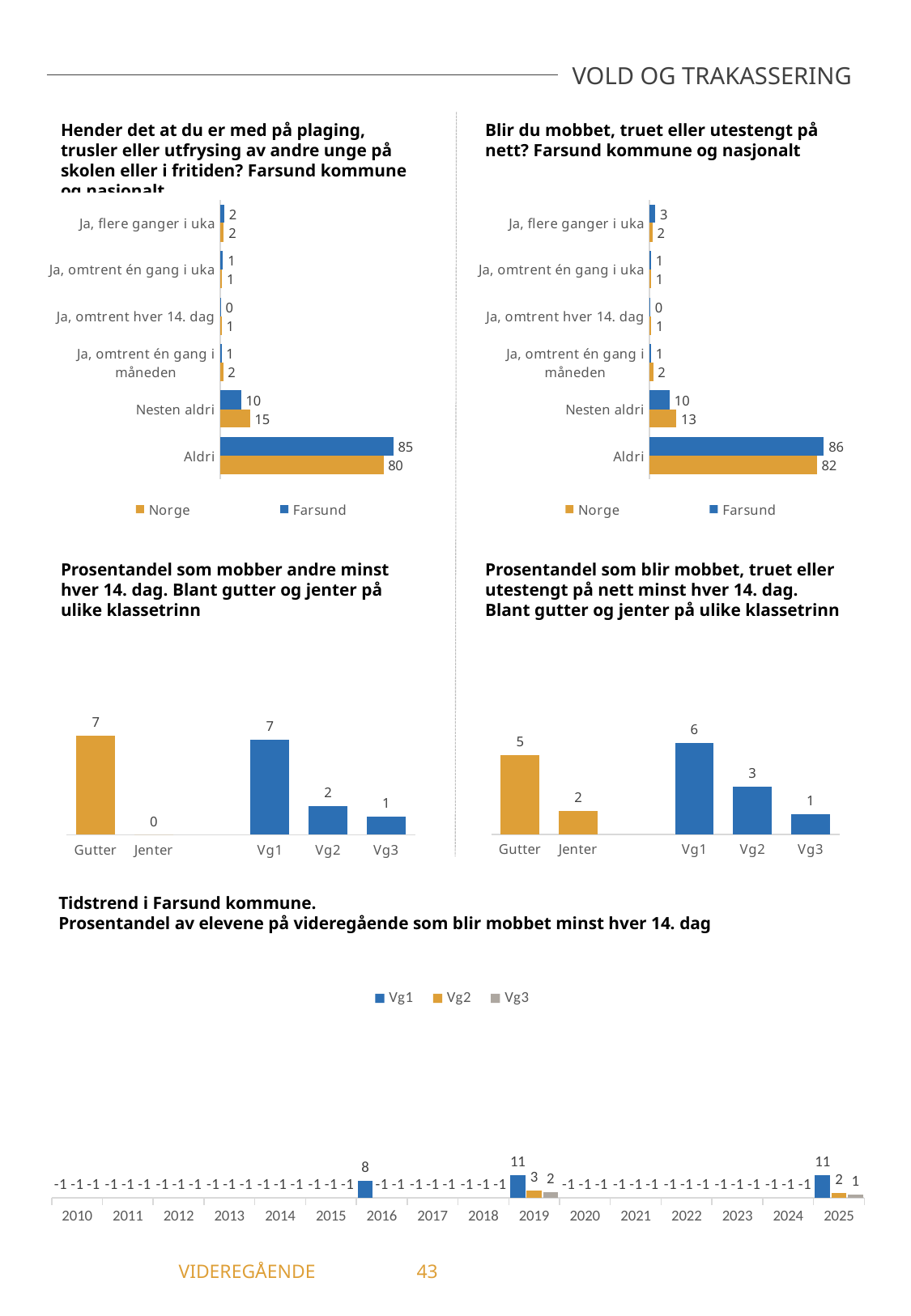
How many series does the legend list in the chart 'Blir du mobbet, truet eller utestengt på nett? Farsund kommune og nasjonalt'? 2 In the chart 'Hender det at du er med på plaging, trusler eller utfrysing av andre unge på skolen eller i fritiden?', what is the Norge value for 'Nesten aldri'? 15 In the chart 'Hender det at du er med på plaging, trusler eller utfrysing av andre unge på skolen eller i fritiden?', what is the Farsund value for 'Aldri'? 85 In the chart 'Prosentandel som mobber andre minst hver 14. dag', which category among Vg1, Vg2 and Vg3 has the lowest value? Vg3 In the chart 'Tidstrend i Farsund kommune', what is the Vg2 value for 2019? 3 In the chart 'Prosentandel som blir mobbet, truet eller utestengt på nett minst hver 14. dag', what is the value for Vg1? 6 In the chart 'Hender det at du er med på plaging, trusler eller utfrysing av andre unge på skolen eller i fritiden?', what is the difference between the Norge and Farsund values for 'Nesten aldri'? 5 In the chart 'Blir du mobbet, truet eller utestengt på nett? Farsund kommune og nasjonalt', which is larger for 'Aldri': Norge or Farsund? Farsund In the chart 'Blir du mobbet, truet eller utestengt på nett? Farsund kommune og nasjonalt', what is the Farsund value for 'Ja, flere ganger i uka'? 3 In the chart 'Tidstrend i Farsund kommune', what is the Vg1 value for 2016? 8 In the chart 'Prosentandel som mobber andre minst hver 14. dag', what is the value for Jenter? 0 In the chart 'Prosentandel som blir mobbet, truet eller utestengt på nett minst hver 14. dag', what is the difference between Gutter and Jenter? 3